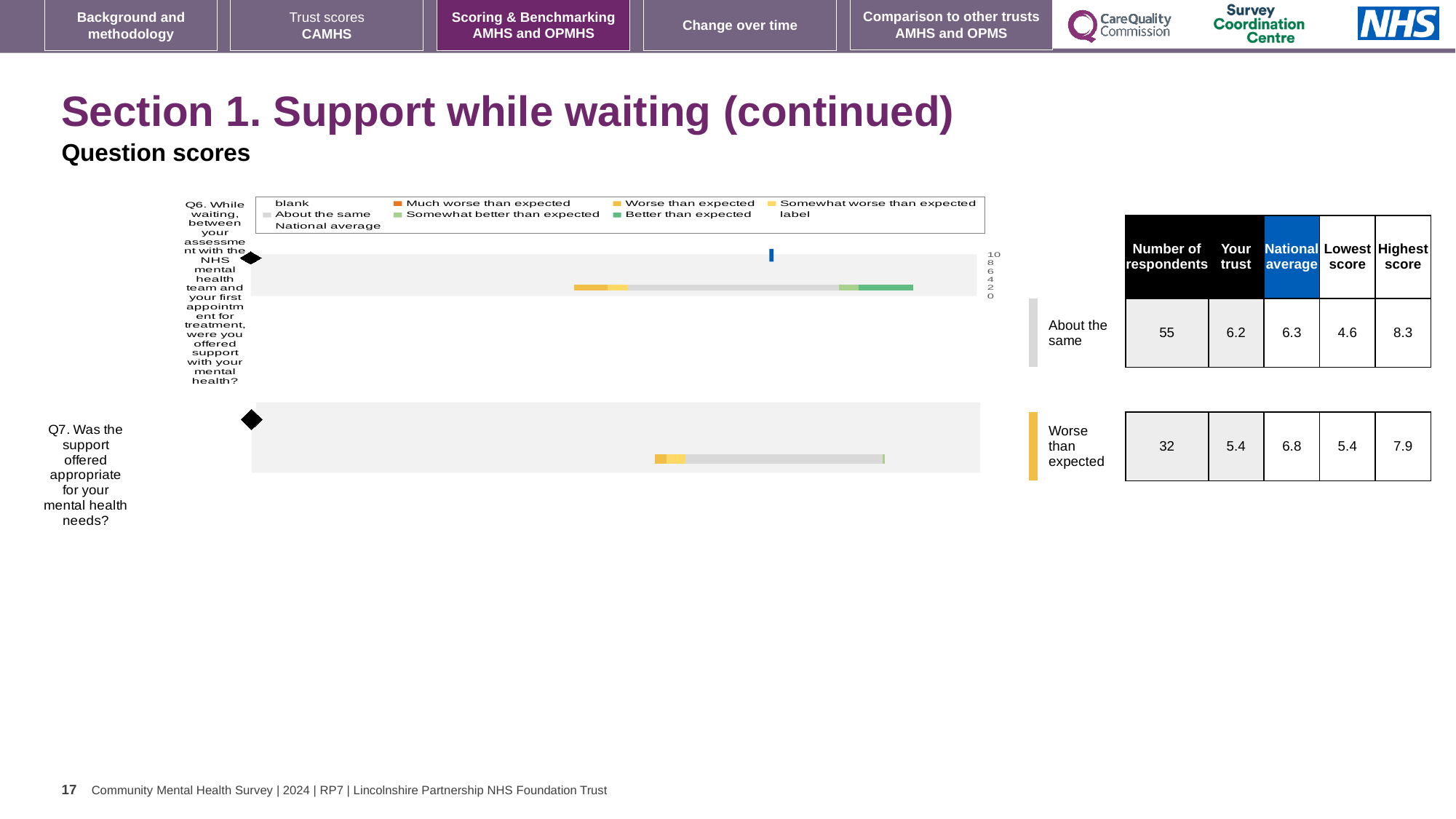
In the table beside the chart, what is the number of respondents for Q6? 55 In the table beside the chart, what is the highest score for Q6? 8.3 How many questions (bars) are plotted in the chart? 2 In the table beside the chart, what is the 'Your trust' score for Q7? 5.4 In the chart legend, what colour represents 'Much worse than expected'? orange In the table beside the chart, what is the national average for Q7? 6.8 Which question has more respondents, Q6 or Q7? Q6 For Q6, what is the difference between the highest score and the lowest score? 3.7 Which benchmark category is shown next to the bar for Q6? About the same Which benchmark category is shown next to the bar for Q7? Worse than expected What kind of chart is shown on the slide? bar chart For Q7, what is the difference between the national average and the 'Your trust' score? 1.4